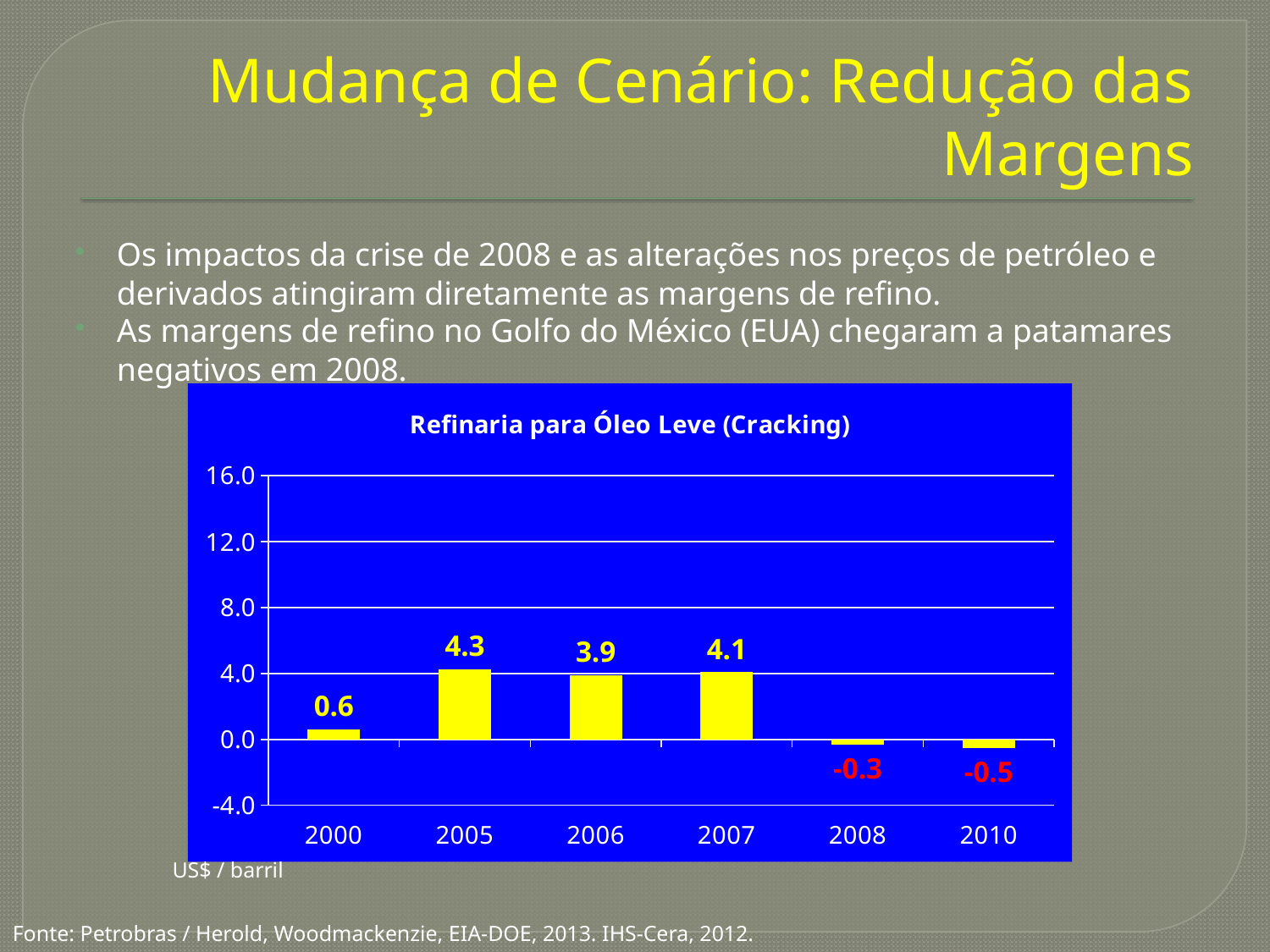
What is the value for 2000? 0.6 How many years are shown on the x axis? 6 What is the value for 2005? 4.3 What is the difference between the values for 2005 and 2006? 0.4 What is the title of the chart? Refinaria para Óleo Leve (Cracking) What kind of chart is shown? bar chart Which is larger, the value for 2007 or the value for 2006? 2007 Which year has the highest value? 2005 Is the value for 2005 greater or less than 4.0? greater Do the values rise or fall from 2007 to 2010? fall Which year has the lowest value? 2010 What is the value for 2008? -0.3